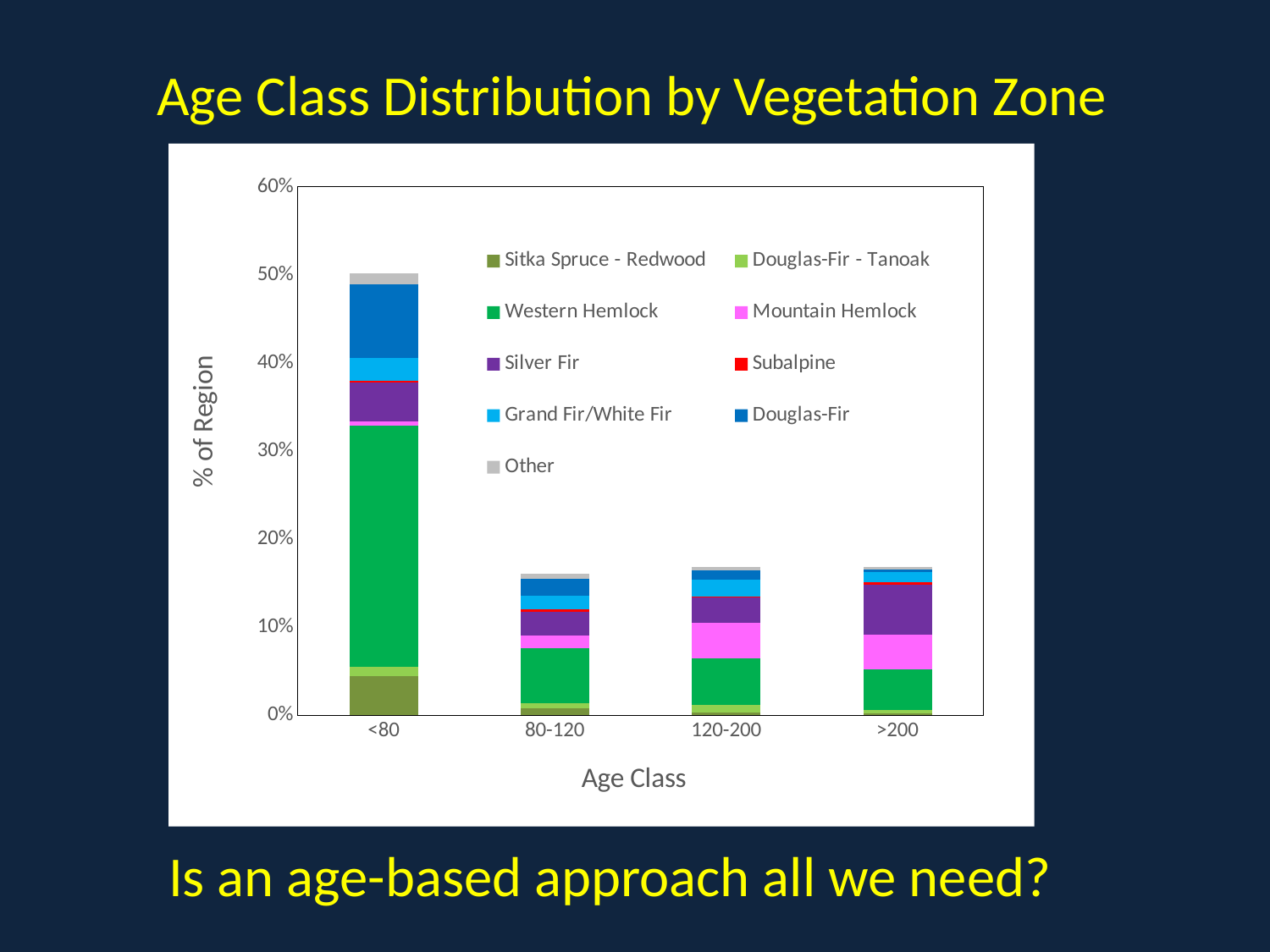
What is the label of the y axis? % of Region Which has a larger total, the <80 age class or the >200 age class? <80 How many series does the legend list? 9 Is the total for the 80-120 age class greater or less than 20%? less What kind of chart is shown on the slide? Stacked bar chart Is the total for the 120-200 age class greater or less than 30%? less How many age class categories are shown on the x axis? 4 Is the total for the >200 age class greater or less than 20%? less Which age class has the tallest stacked bar? <80 What is the title of the chart? Age Class Distribution by Vegetation Zone